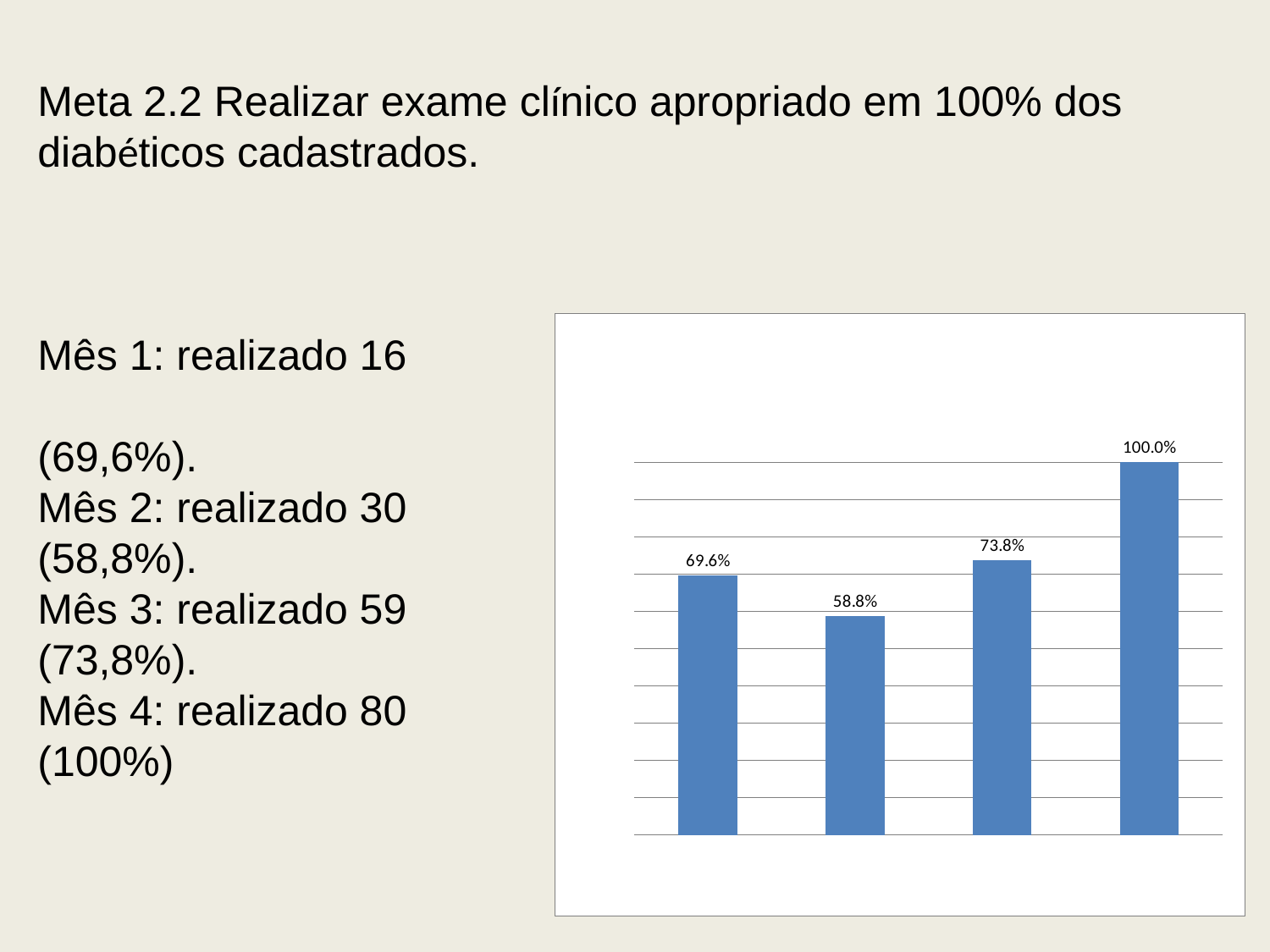
How many bars are plotted in the chart? 4 What is the value shown on the second bar from the left in the chart? 58.8% What type of chart is shown on the slide? bar chart What is the value shown on the third bar from the left in the chart? 73.8% Which bar in the chart has the highest value? the fourth (rightmost) bar, 100.0% What is the value shown on the first (leftmost) bar of the chart? 69.6% Which is larger in the chart, the value of the first bar or the value of the third bar? the third bar (73.8%) What colour are the bars in the chart? blue Which bar in the chart has the lowest value? the second bar, 58.8% What is the difference between the values of the third bar and the second bar in the chart? 15.0% What is the difference between the values of the fourth bar and the first bar in the chart? 30.4% What is the value shown on the fourth (rightmost) bar of the chart? 100.0%